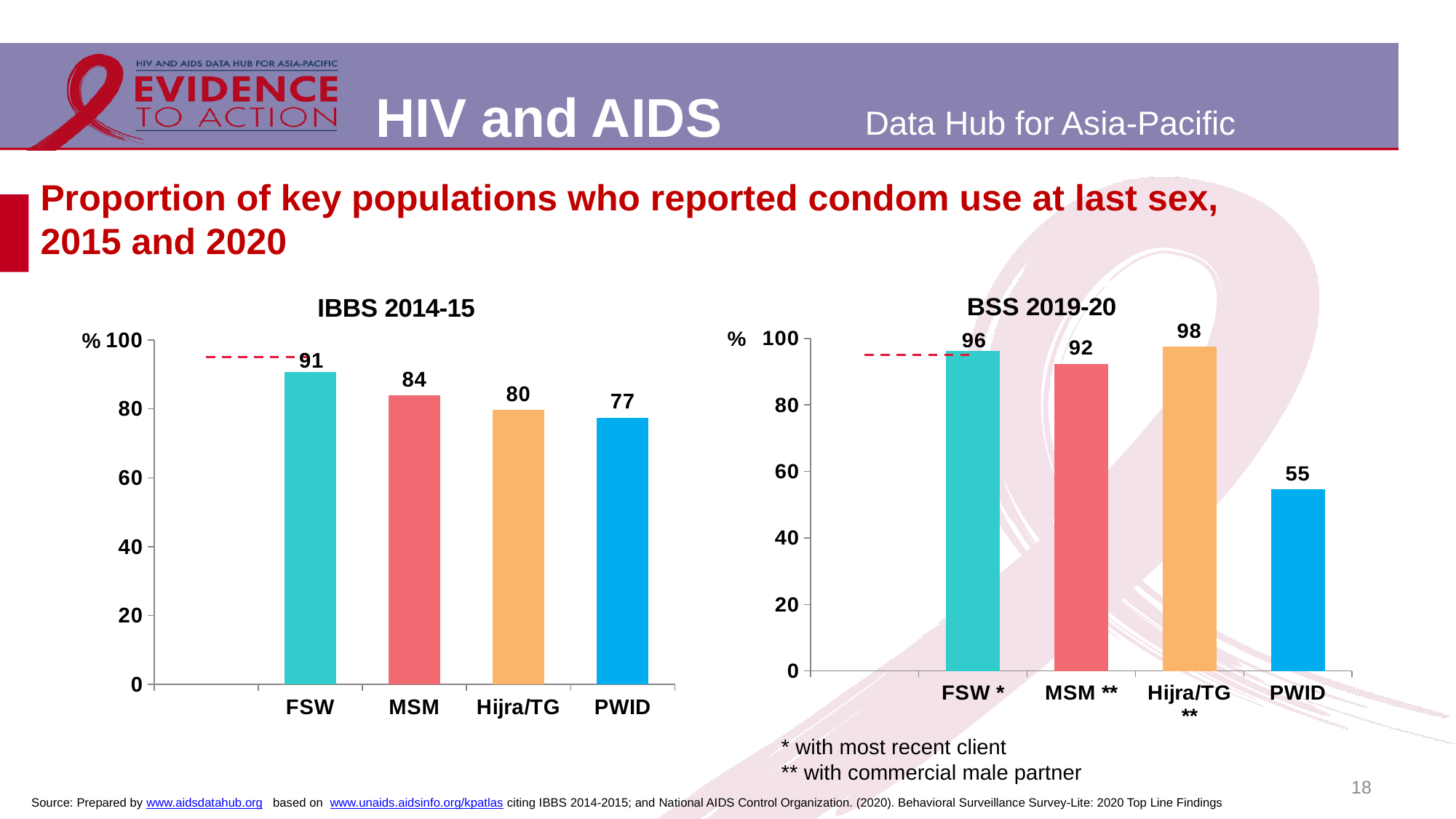
In the BSS 2019-20 chart, what is the value for PWID? 55 In the BSS 2019-20 chart, what is the difference between the values for Hijra/TG ** and PWID? 43 In the IBBS 2014-15 chart, what is the difference between the values for FSW and PWID? 14 In the IBBS 2014-15 chart, which category has the highest value? FSW In the IBBS 2014-15 chart, which is larger, the value for MSM or the value for Hijra/TG? MSM In the IBBS 2014-15 chart, do the values rise or fall from FSW to PWID? Fall What kind of chart is the IBBS 2014-15 chart? Bar chart In the BSS 2019-20 chart, which category has the lowest value? PWID In the IBBS 2014-15 chart, what is the value for MSM? 84 In the IBBS 2014-15 chart, what is the value for Hijra/TG? 80 How many categories are shown in the BSS 2019-20 chart? 4 In the BSS 2019-20 chart, which category has the highest value? Hijra/TG **